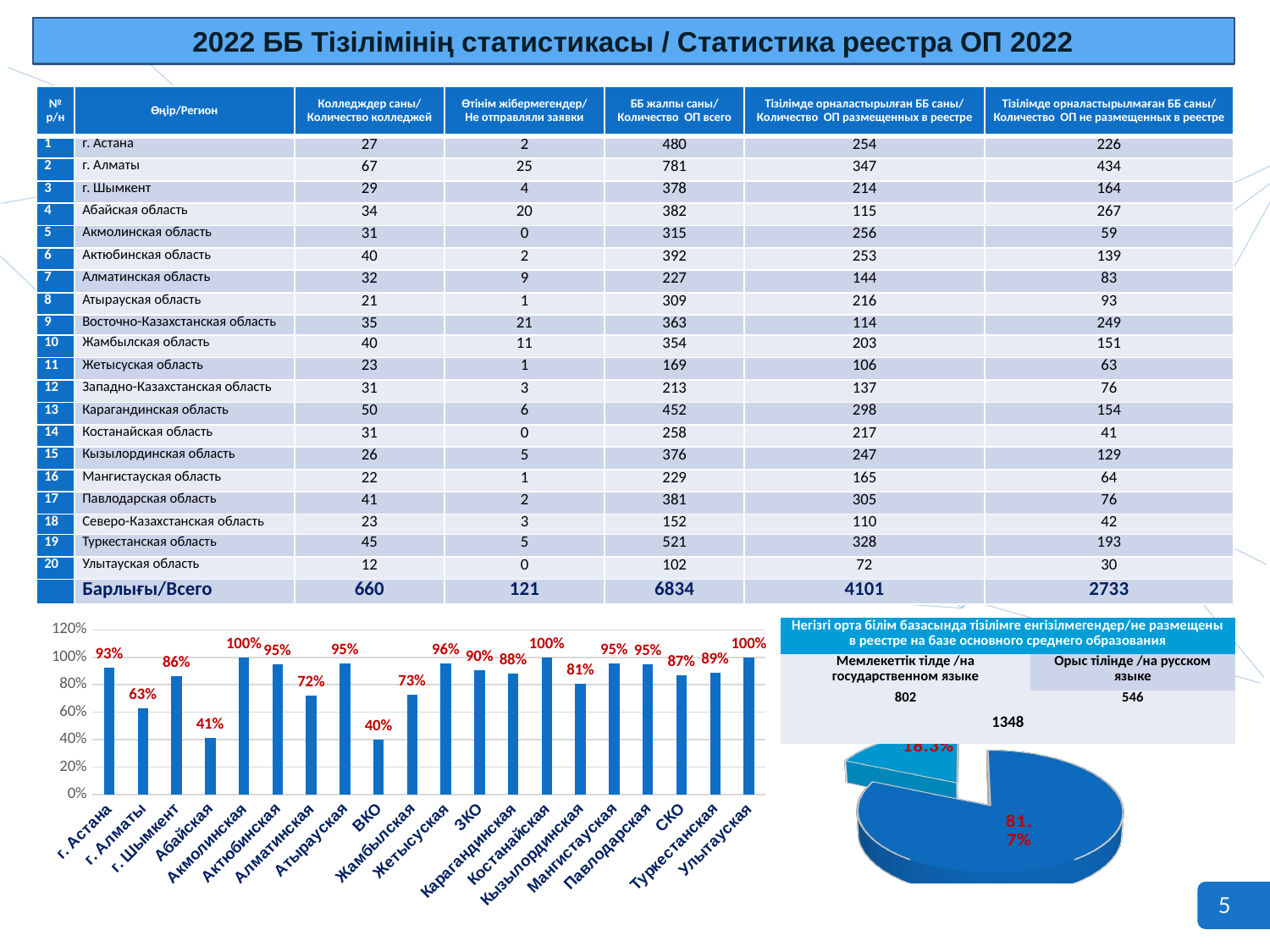
In the bar chart at the bottom left, which is larger, the value for Жамбылская or the value for Алматинская? Жамбылская In the pie chart at the bottom right, what share does the largest slice have? 81.7% In the bar chart at the bottom left, how many categories have a value of 100%? 3 What kind of chart is shown at the bottom right of the slide? pie chart In the bar chart at the bottom left, what is the value for Абайская? 41% In the bar chart at the bottom left, what is the value for Кызылординская? 81% In the bar chart at the bottom left, what is the value for г. Астана? 93% What kind of chart is shown at the bottom left of the slide? bar chart In the bar chart at the bottom left, what is the value for ВКО? 40% In the bar chart at the bottom left, how many categories are shown on the x axis? 20 In the bar chart at the bottom left, which category has the lowest value? ВКО In the bar chart at the bottom left, what is the difference between the values for г. Астана and г. Алматы? 30%